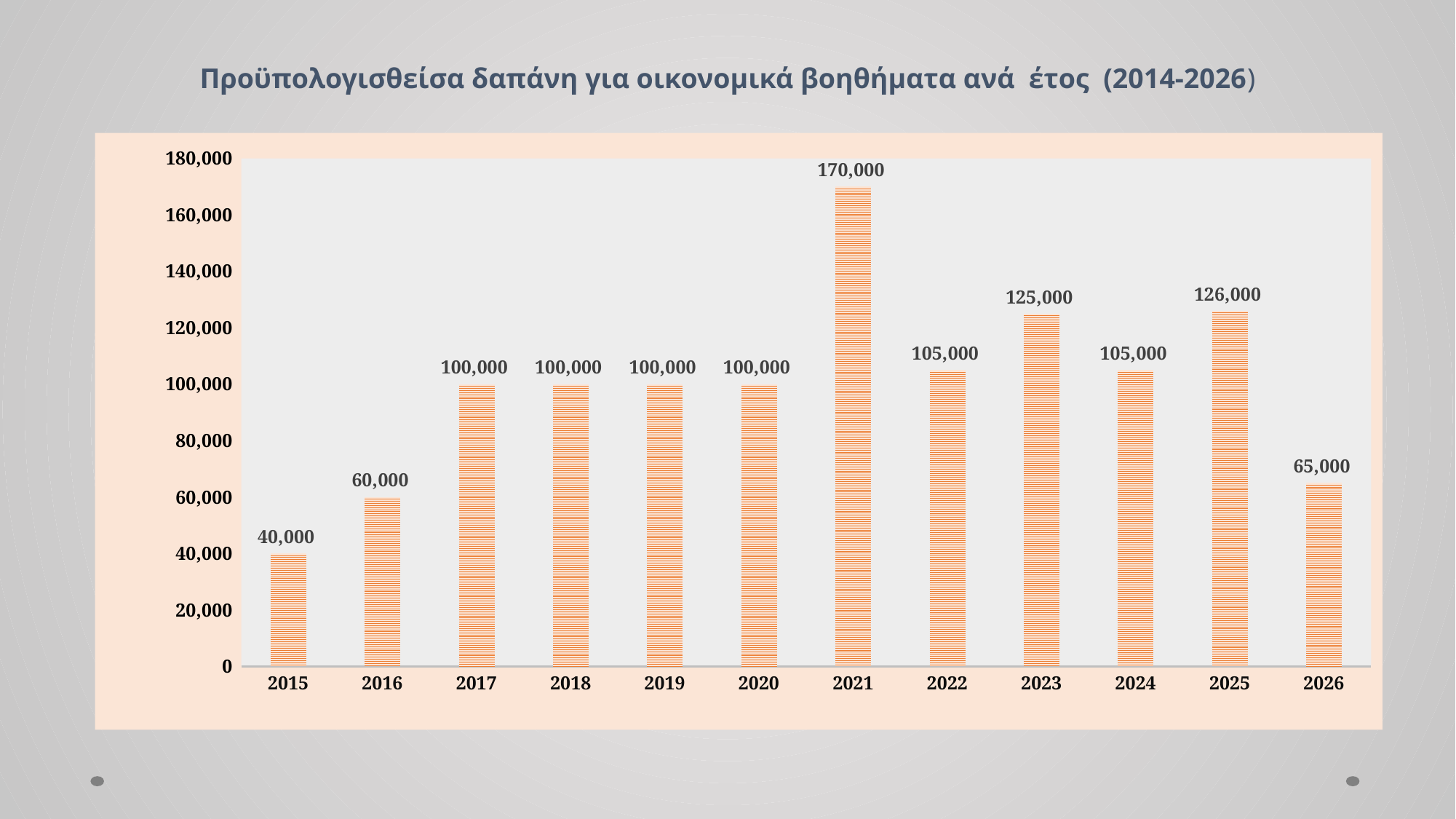
What is the difference between the values for 2016 and 2015? 20,000 How many years are shown on the x axis? 12 What kind of chart is shown on the slide? bar chart What is the value for 2026? 65,000 Do the values rise or fall from 2015 to 2017? rise What is the value for 2021? 170,000 What is the difference between the values for 2021 and 2023? 45,000 Is the value for 2026 greater or less than 80,000? less Which is larger, the value for 2025 or the value for 2022? 2025 What is the value for 2015? 40,000 Which year has the lowest value? 2015 Which year has the highest value? 2021